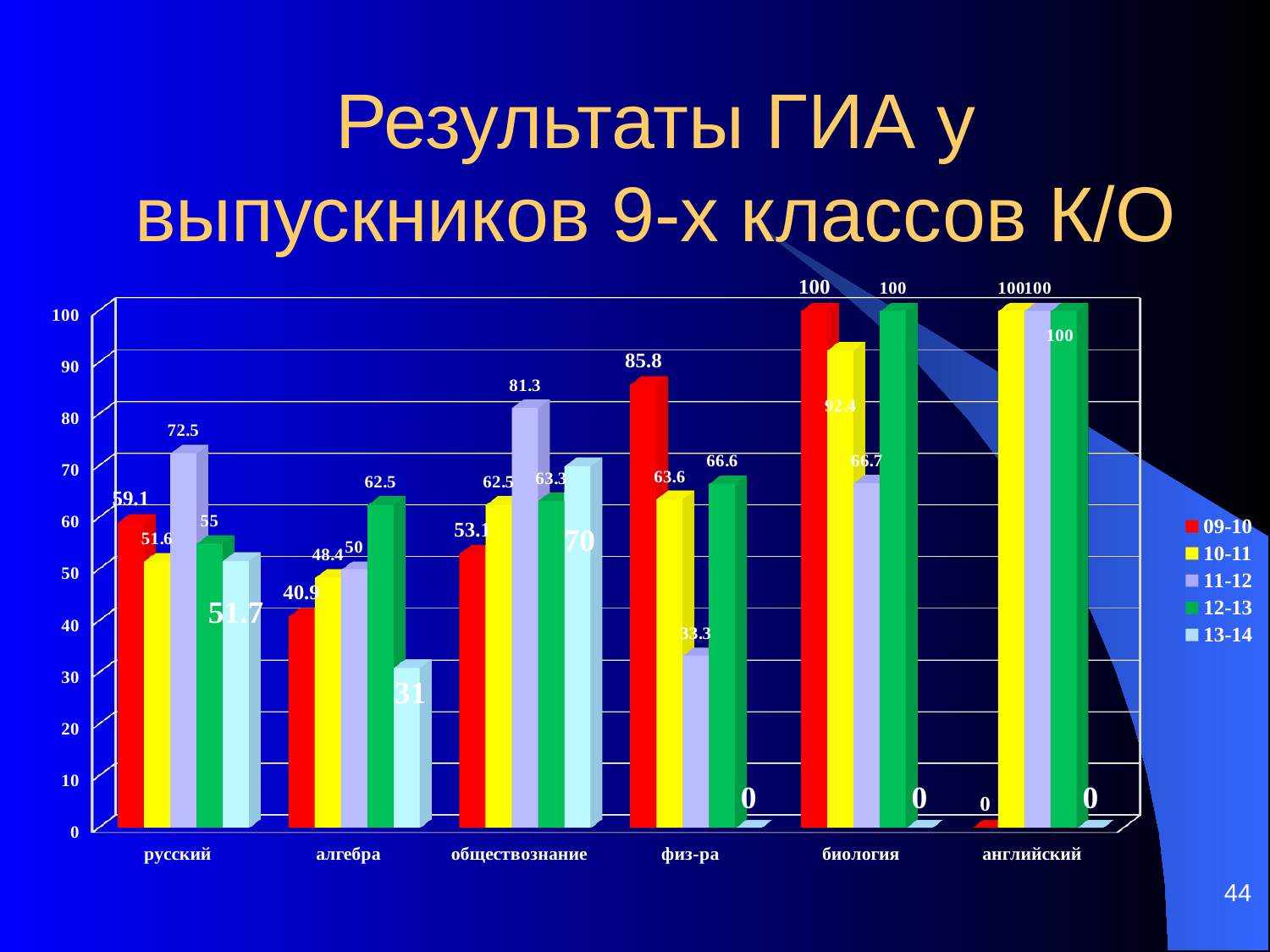
What colour represents the 09-10 series in the legend? red What is the value for 09-10 in the физ-ра category? 85.8 What is the value for 11-12 in the русский category? 72.5 What is the value for 10-11 in the биология category? 92.4 How many subject categories are shown on the x axis? 6 Which series has the lowest value in the алгебра category? 13-14 How many series does the legend list? 5 In the физ-ра category, which is larger: the 10-11 value or the 12-13 value? 12-13 Which series has the highest value in the русский category? 11-12 What is the value for 13-14 in the алгебра category? 31 What kind of chart is shown on the slide? bar chart In the обществознание category, what is the difference between the 11-12 value and the 09-10 value? 28.2